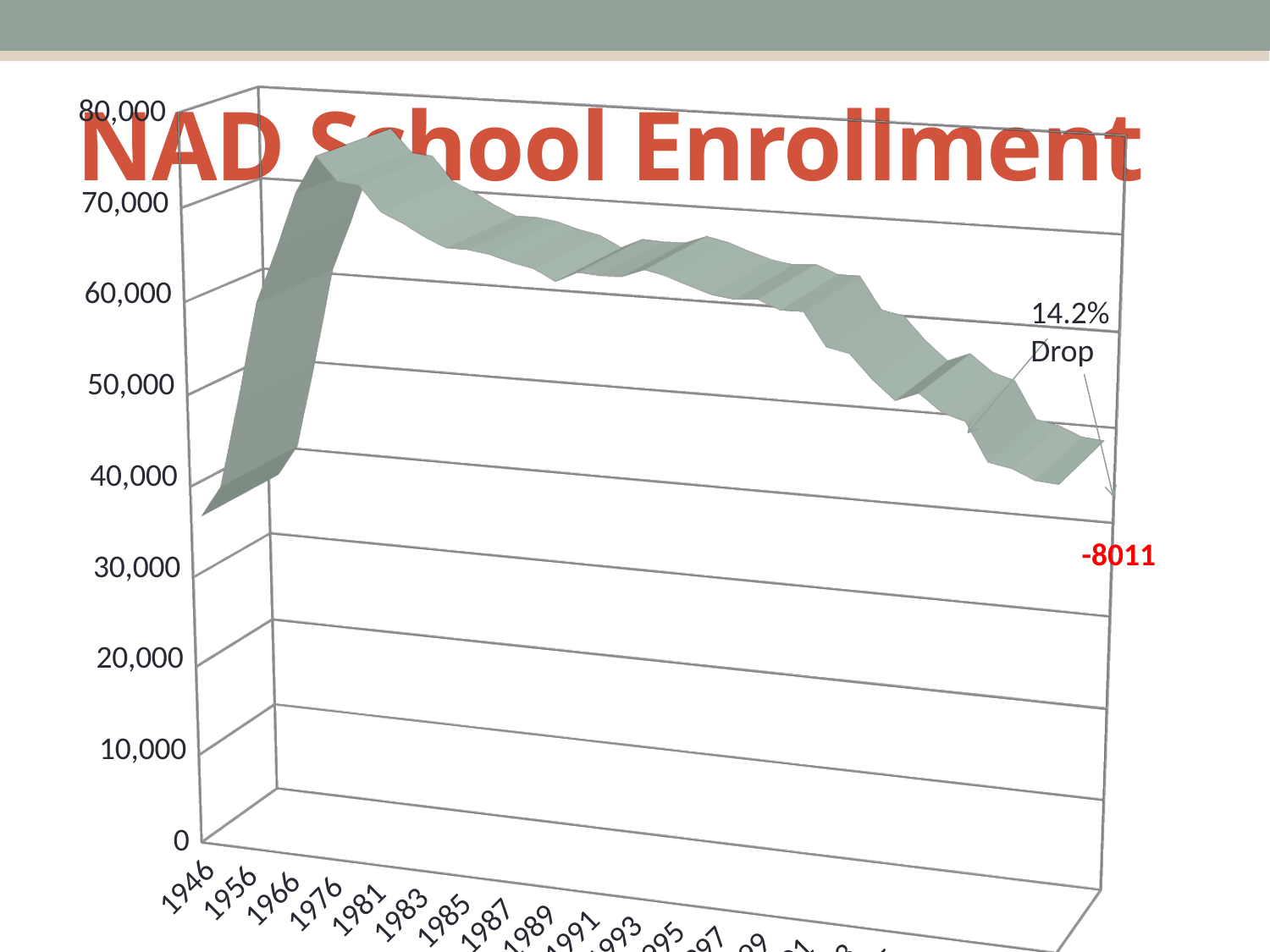
What kind of chart is shown on the slide? 3D line chart What percentage drop is annotated on the chart? 14.2% Does enrollment rise or fall from 1946 to 1976? rise Does enrollment generally rise or fall after 1981? fall Which year has the larger enrollment, 1956 or 1966? 1966 What is the title of the chart? NAD School Enrollment Which year has the larger enrollment, 1946 or 1976? 1976 Is the enrollment value for 1976 greater or less than 70,000? greater What is the highest value shown on the vertical axis? 80,000 Is the enrollment value for 1956 greater or less than 40,000? greater Is the enrollment value for 1946 greater or less than 50,000? less What number in red is shown next to the annotated drop on the chart? -8011